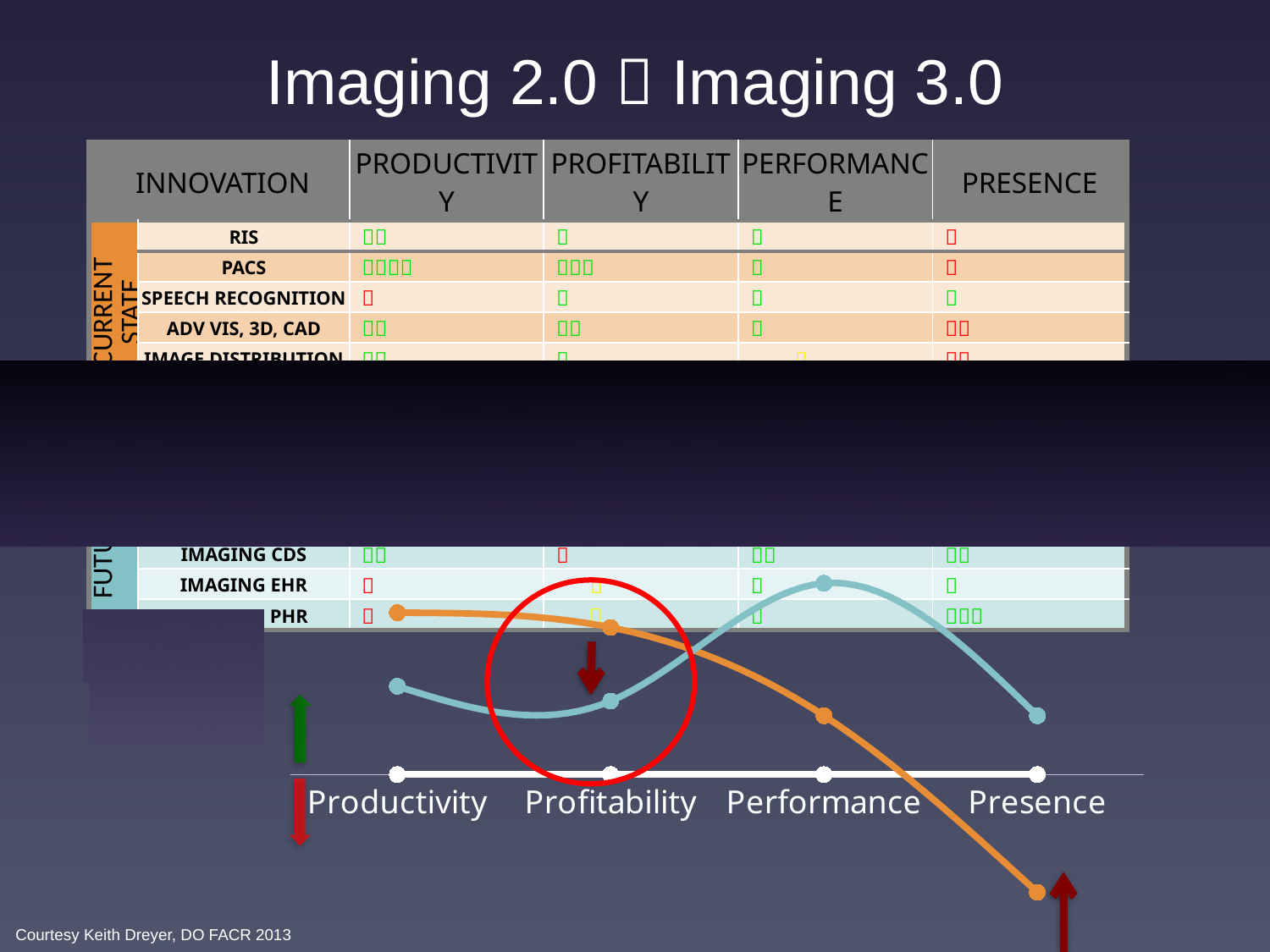
Which category has the highest value on the orange line? Productivity At Productivity, which line has the higher value, orange or blue? orange At Performance, which line has the higher value, orange or blue? blue Which category has the lowest value on the orange line? Presence At Presence, which line has the higher value, orange or blue? blue What kind of chart is shown at the bottom of the slide? line chart How many lines are plotted on the line chart? 3 Which category has the highest value on the blue line? Performance How many categories are shown on the x axis of the line chart? 4 Which category on the x axis is circled in red on the chart? Profitability Does the orange line rise or fall from Productivity to Presence? fall What is the first category label on the x axis of the line chart? Productivity